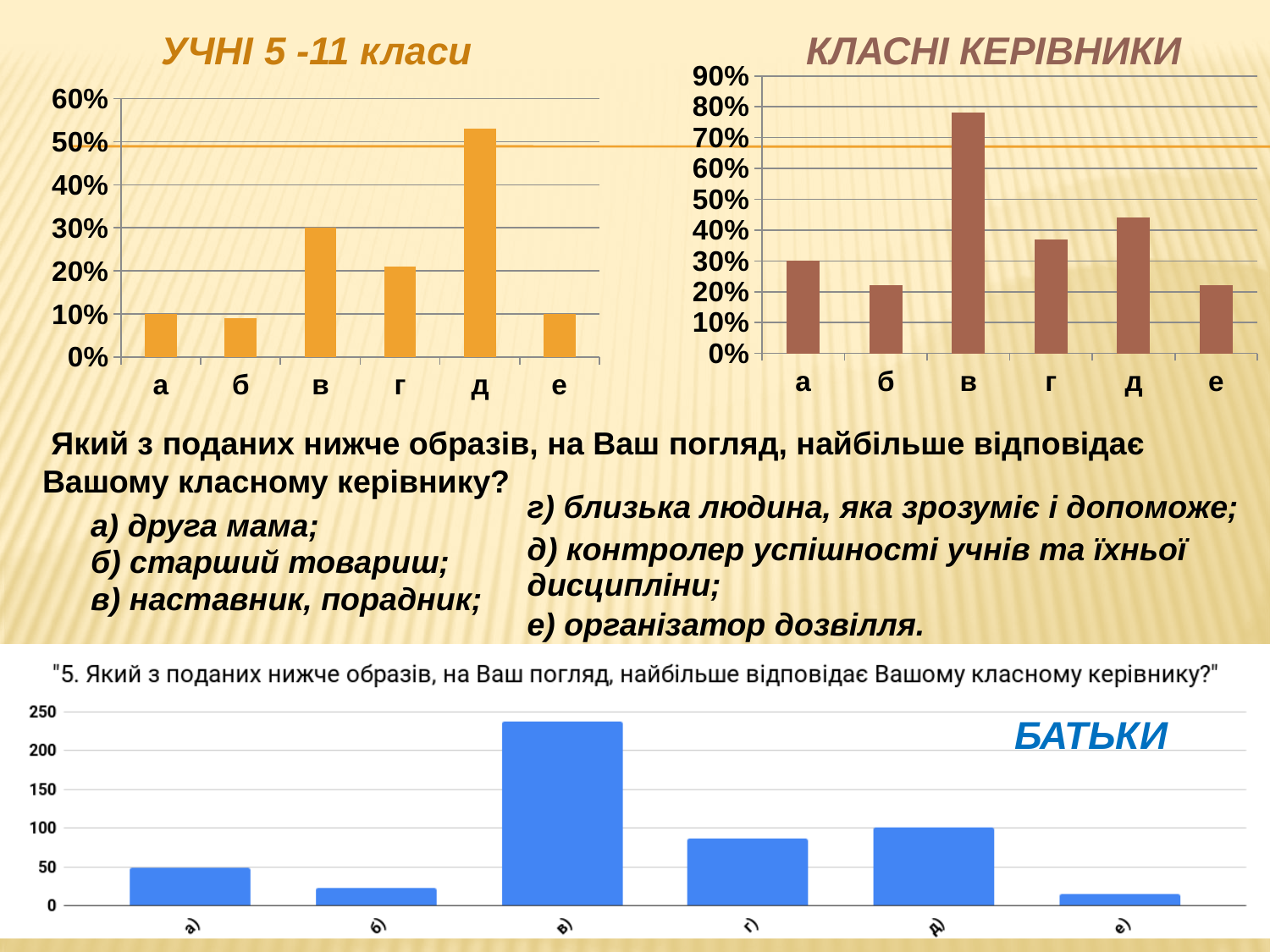
In the УЧНІ 5-11 класи chart, which is larger, the value for в or the value for г? в In the УЧНІ 5-11 класи chart, what is the value for в? 30% In the БАТЬКИ chart at the bottom, which category has the highest value? в In the УЧНІ 5-11 класи chart, which category has the highest value? д In the БАТЬКИ chart at the bottom, which category has the lowest value? е In the УЧНІ 5-11 класи chart, is the value for д greater or less than 50%? greater In the БАТЬКИ chart at the bottom, is the value for в greater or less than 200? greater In the КЛАСНІ КЕРІВНИКИ chart, which is larger, the value for г or the value for д? д In the КЛАСНІ КЕРІВНИКИ chart, which category has the highest value? в How many categories are shown on the x axis of the БАТЬКИ chart at the bottom? 6 In the КЛАСНІ КЕРІВНИКИ chart, what is the value for а? 30% In the КЛАСНІ КЕРІВНИКИ chart, is the value for в greater or less than 70%? greater